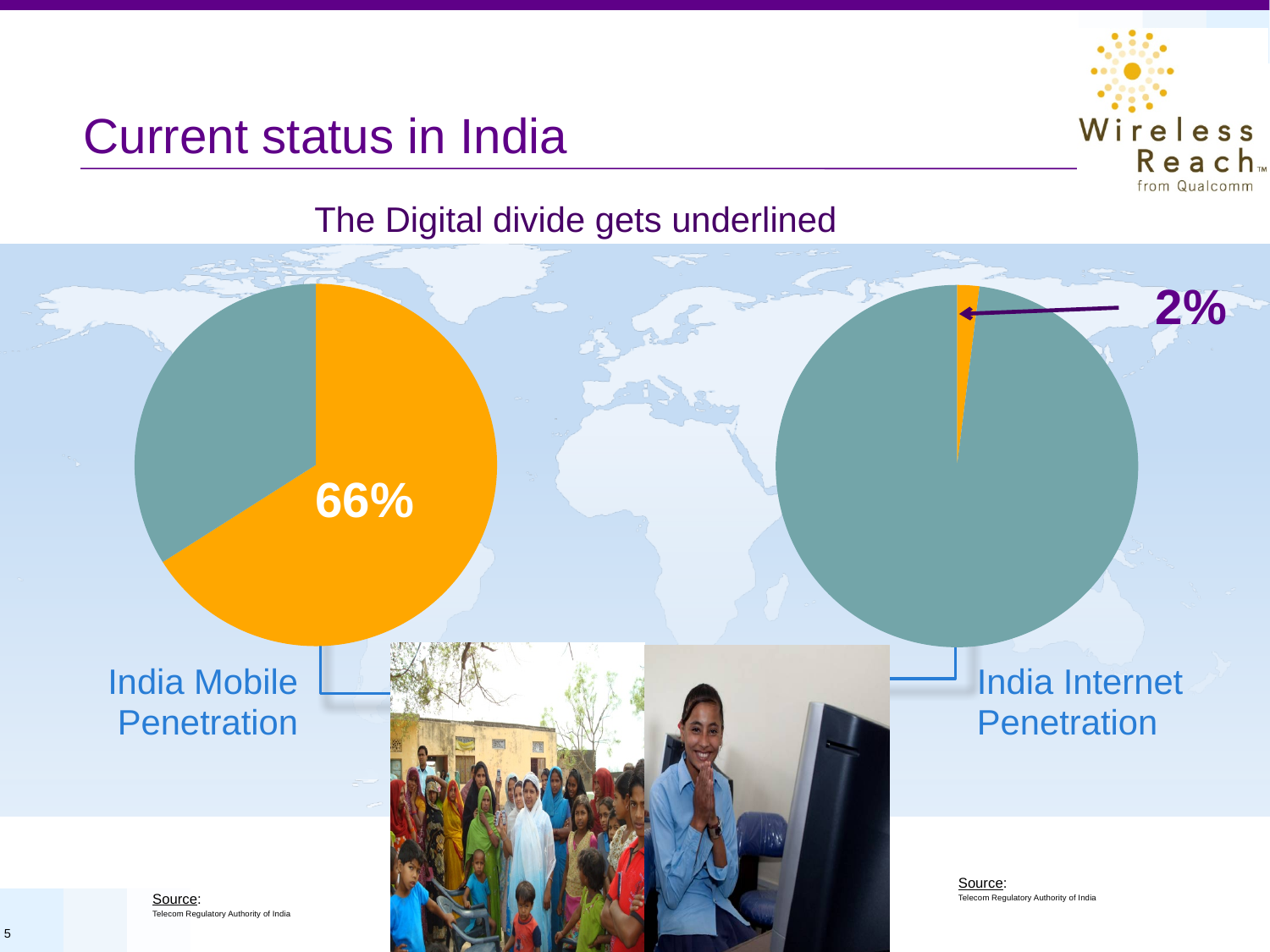
In the India Mobile Penetration chart, is the orange slice greater or less than 50% of the pie? greater How many slices does the India Mobile Penetration pie chart have? 2 In the India Mobile Penetration chart, what value is printed on the orange slice? 66% What is the title of the pie chart on the left of the slide? India Mobile Penetration What type of chart is used for India Internet Penetration? pie chart What colour is the slice labelled 2% in the India Internet Penetration chart? orange In the India Internet Penetration chart, is the orange slice greater or less than 50% of the pie? less What is the difference between the labelled share in the India Mobile Penetration chart (66%) and the labelled share in the India Internet Penetration chart (2%)? 64 percentage points Which is larger, the labelled share in the India Mobile Penetration chart or the labelled share in the India Internet Penetration chart? India Mobile Penetration What type of chart is used for India Mobile Penetration? pie chart How many slices does the India Internet Penetration pie chart have? 2 In the India Internet Penetration chart, what value is labelled for the orange slice? 2%